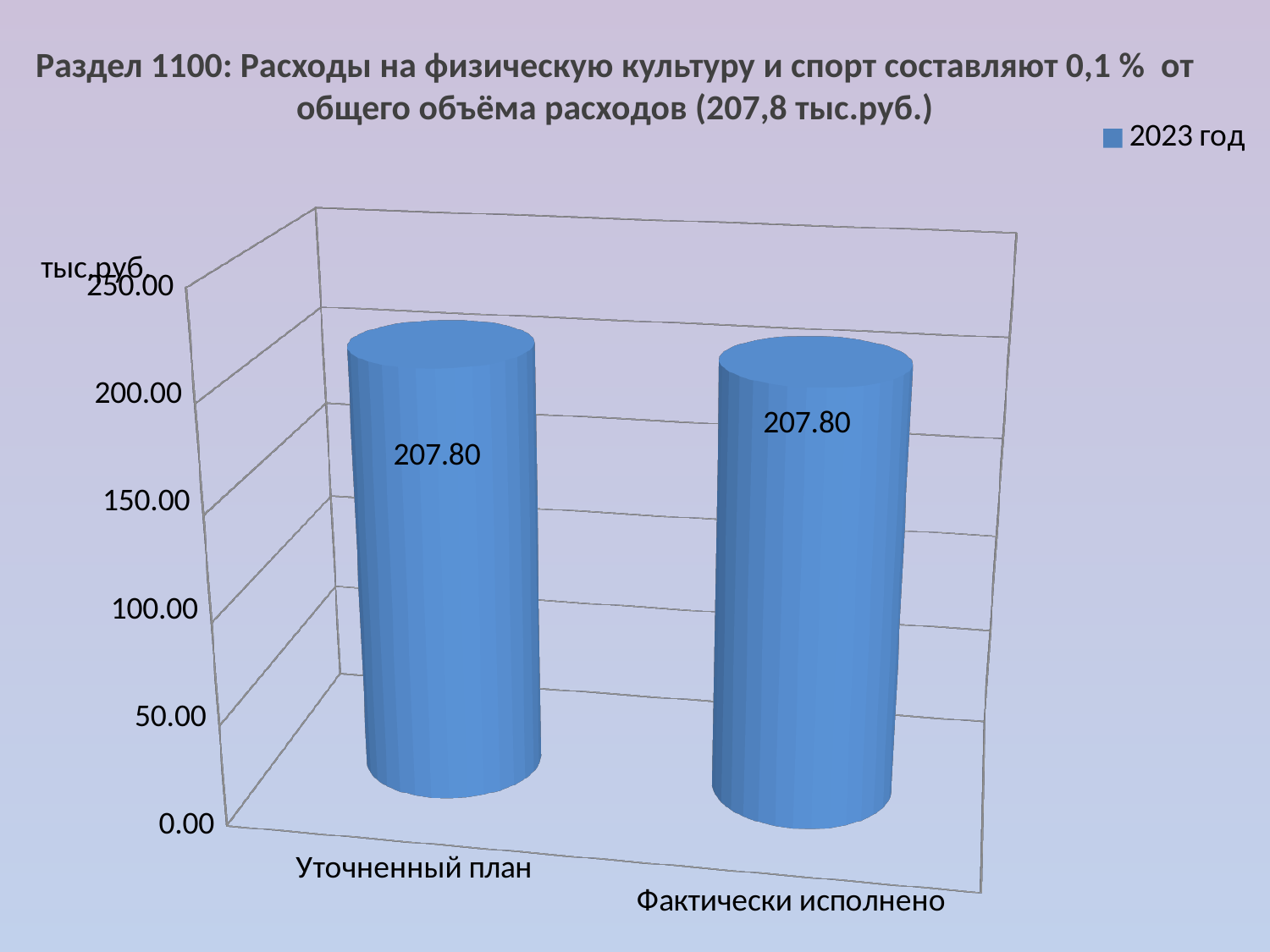
What is the highest tick value shown on the vertical axis? 250.00 What is the value for Уточненный план? 207.80 What series name is shown in the legend? 2023 год What unit label is shown on the vertical axis? тыс.руб Is the value for Фактически исполнено greater or less than 250.00? less How many categories are shown on the x axis? 2 What kind of chart is shown on the slide? bar chart What is the difference between the values for Уточненный план and Фактически исполнено? 0.00 How many series does the legend list? 1 What is the value for Фактически исполнено? 207.80 Is the value for Уточненный план greater or less than 200.00? greater